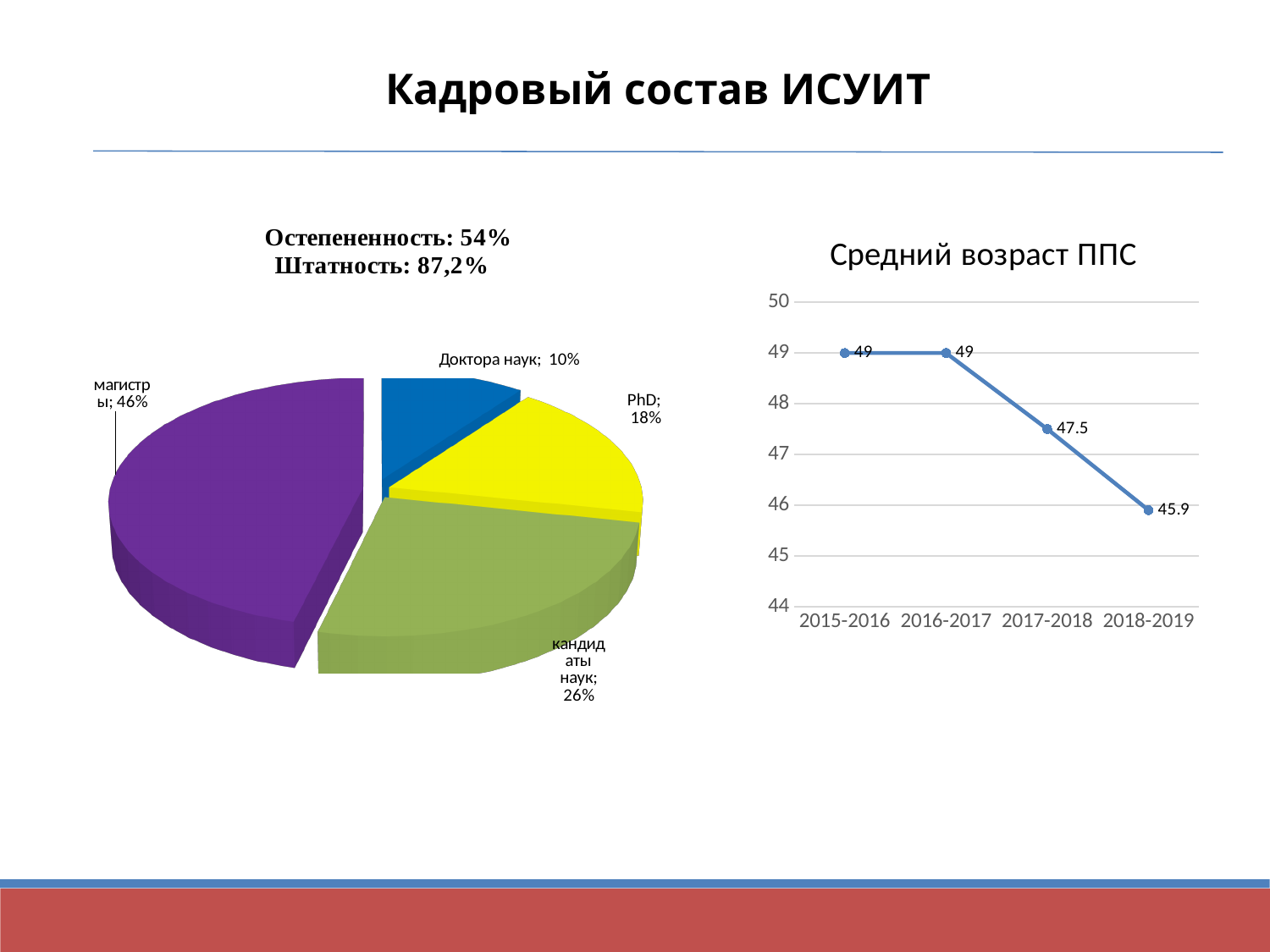
In the pie chart on the left, what share do магистры have? 46% In the pie chart on the left, what share do Доктора наук have? 10% In the pie chart on the left, how many slices are there? 4 In the chart titled 'Средний возраст ППС', what is the value for 2017-2018? 47.5 In the pie chart on the left, what is the difference in percentage points between кандидаты наук and PhD? 8 In the chart titled 'Средний возраст ППС', how many data points are plotted? 4 In the pie chart on the left, which category has the smallest slice? Доктора наук In the pie chart on the left, what share do кандидаты наук have? 26% In the chart titled 'Средний возраст ППС', do the values rise or fall from 2016-2017 to 2018-2019? fall In the chart titled 'Средний возраст ППС', what is the value for 2018-2019? 45.9 In the pie chart on the left, which category has the largest slice? магистры In the chart titled 'Средний возраст ППС', what kind of chart is shown? line chart